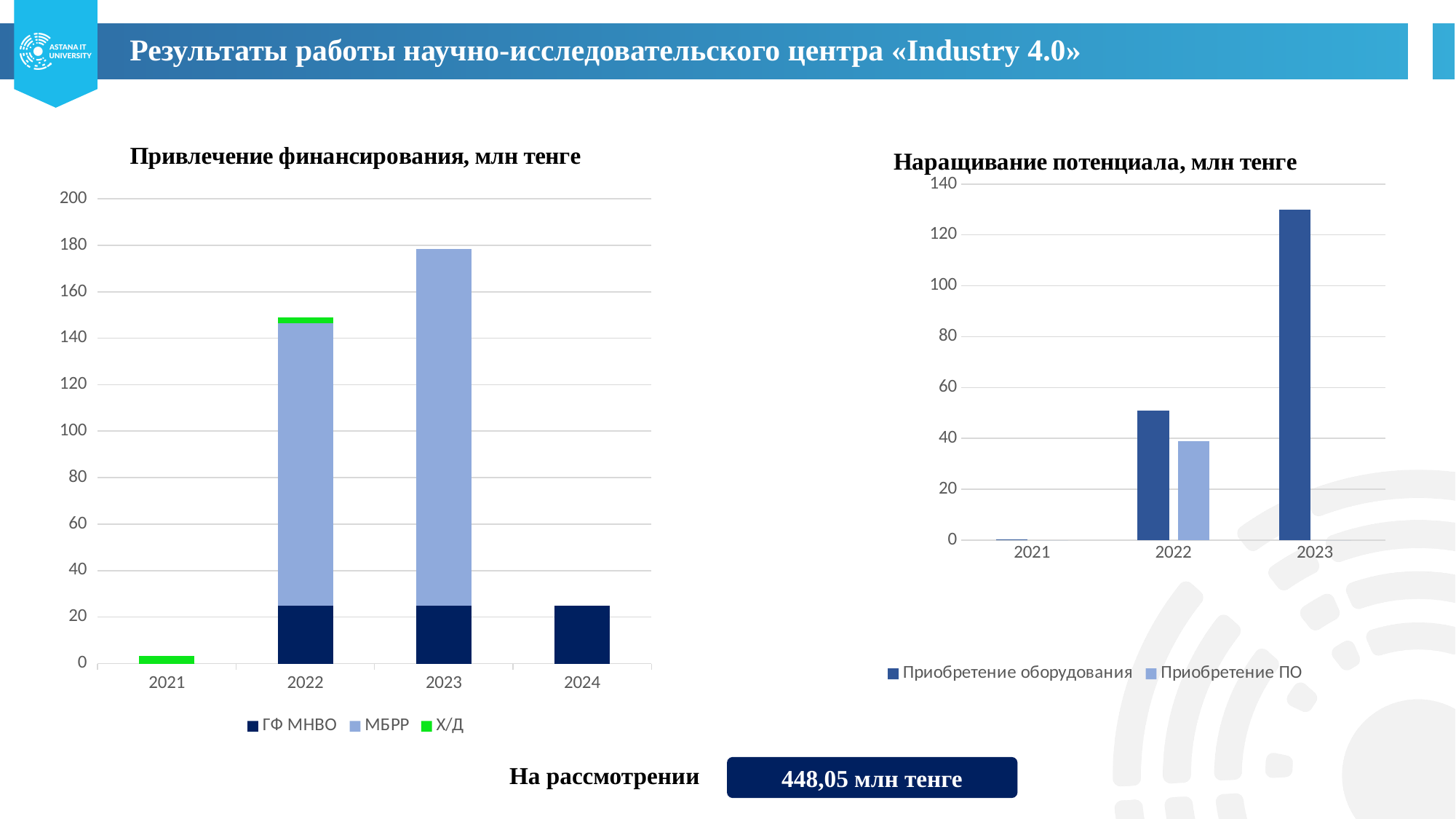
In the right chart «Наращивание потенциала, млн тенге», which year has the highest value for Приобретение оборудования? 2023 In the left chart «Привлечение финансирования, млн тенге», how many series does the legend list? 3 In the right chart «Наращивание потенциала, млн тенге», is the value for Приобретение оборудования in 2023 greater or less than 120? greater In the right chart «Наращивание потенциала, млн тенге», in 2022 which is larger: Приобретение оборудования or Приобретение ПО? Приобретение оборудования In the left chart «Привлечение финансирования, млн тенге», which year has the shortest bar? 2021 In the left chart «Привлечение финансирования, млн тенге», is the value for 2024 greater or less than 40? less In the left chart «Привлечение финансирования, млн тенге», how many years are shown on the x axis? 4 In the left chart «Привлечение финансирования, млн тенге», which series is shown in green? Х/Д In the left chart «Привлечение финансирования, млн тенге», is the total stacked value for 2023 greater or less than 160? greater In the left chart «Привлечение финансирования, млн тенге», which year has the tallest stacked bar? 2023 In the right chart «Наращивание потенциала, млн тенге», how many series does the legend list? 2 What kind of chart is the left chart titled «Привлечение финансирования, млн тенге»? bar chart